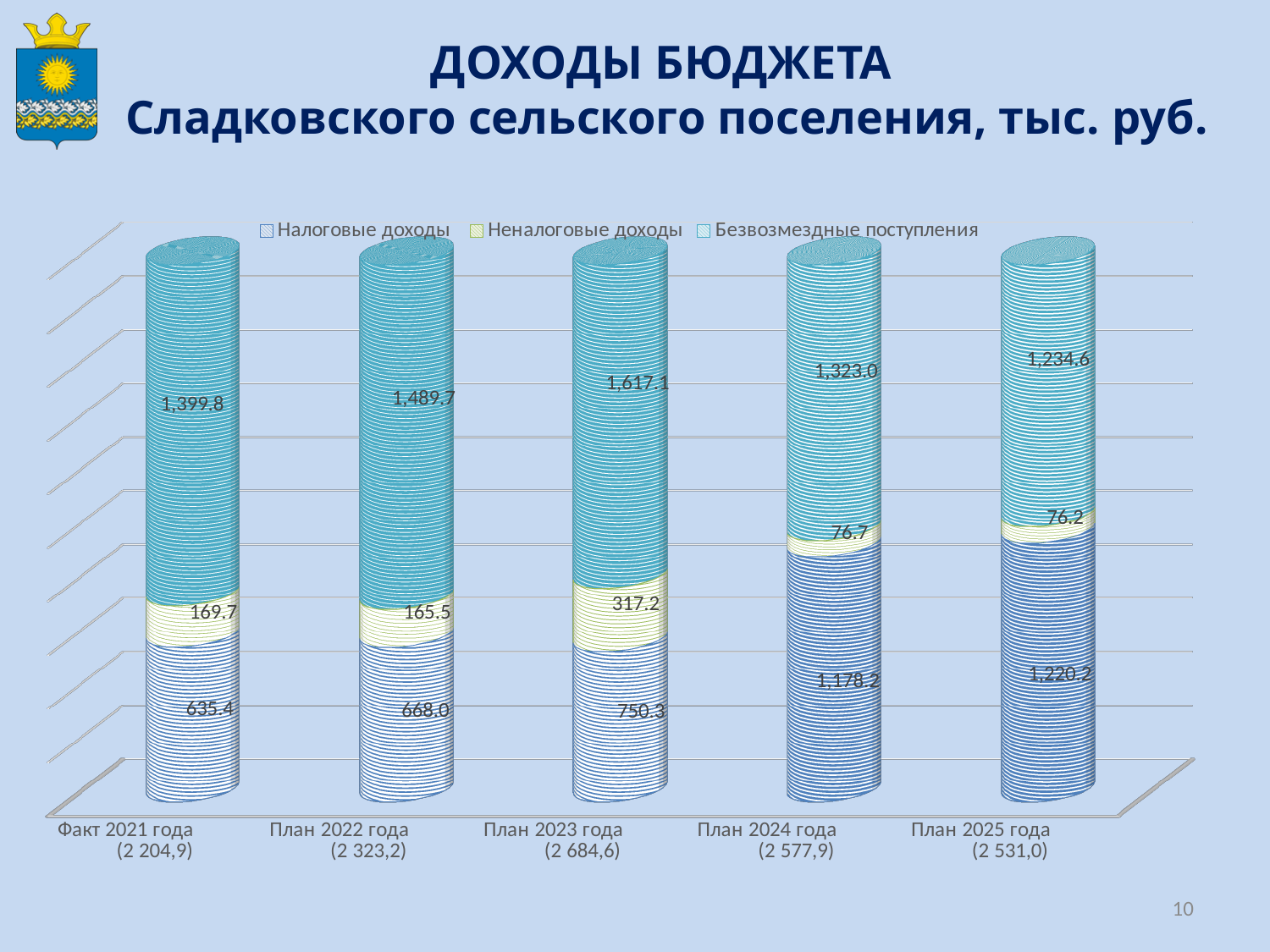
What is the value of Безвозмездные поступления for План 2023 года? 1,617.1 How many years (categories) are shown on the x axis? 5 Which year has the lowest value of Неналоговые доходы? План 2025 года What is the total budget income shown for План 2023 года? 2 684,6 Which is larger: Неналоговые доходы for План 2023 года or for План 2022 года? План 2023 года What is the value of Неналоговые доходы for План 2025 года? 76.2 Which year has the highest value of Безвозмездные поступления? План 2023 года Do the values of Налоговые доходы rise or fall from Факт 2021 года to План 2025 года? Rise How many series does the legend list? 3 What is the difference between Налоговые доходы for План 2025 года and План 2024 года? 42.0 What is the value of Налоговые доходы for Факт 2021 года? 635.4 What kind of chart is shown on the slide? Stacked bar chart